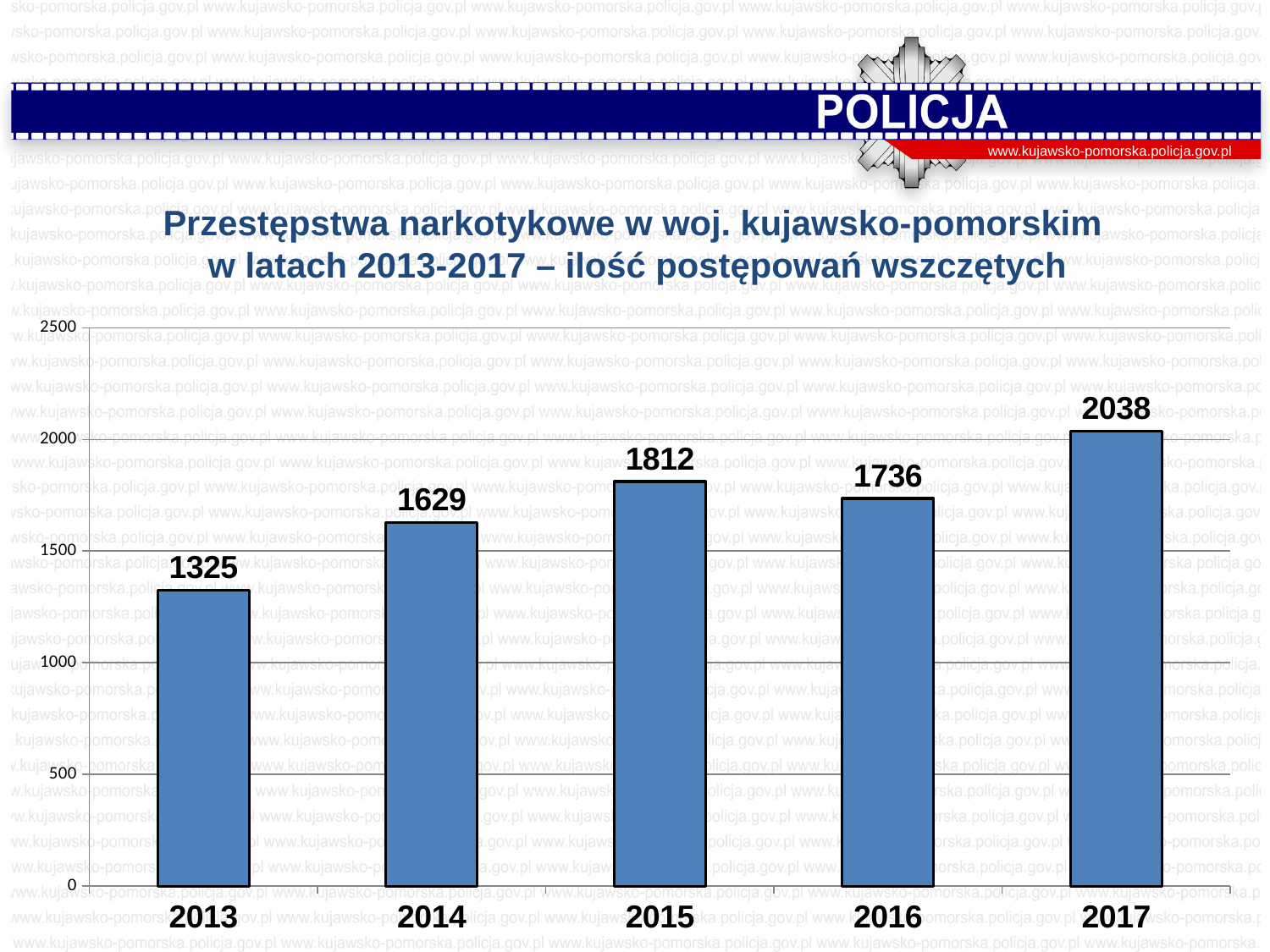
Which is larger, the value for 2014 or the value for 2016? 2016 What is the value for 2017? 2038 What is the value for 2015? 1812 What is the value for 2013? 1325 What is the title of the chart? Przestępstwa narkotykowe w woj. kujawsko-pomorskim w latach 2013-2017 – ilość postępowań wszczętych What kind of chart is shown on the slide? bar chart Which year has the lowest value? 2013 How many years are shown on the chart? 5 What is the difference between the values for 2017 and 2013? 713 What is the difference between the values for 2015 and 2016? 76 Is the value for 2017 greater or less than 2000? greater Which year has the highest value? 2017